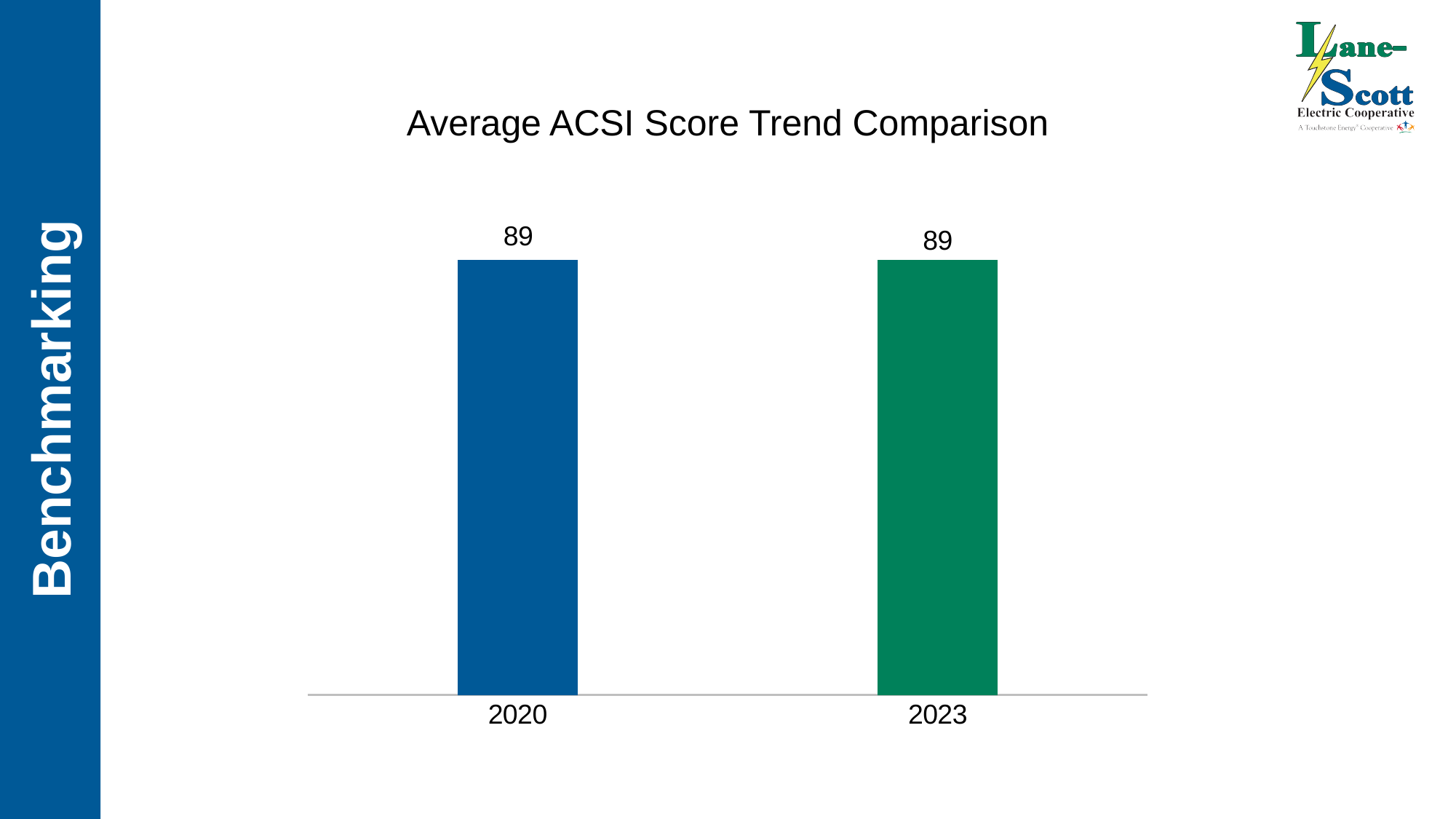
How many categories are shown on the x axis of the chart? 2 What is the title of the chart? Average ACSI Score Trend Comparison Which years are compared in the chart? 2020 and 2023 What colour is the bar for 2023? Green What is the average ACSI score for 2020? 89 What is the average ACSI score for 2023? 89 Does the average ACSI score rise, fall, or stay the same from 2020 to 2023? Stays the same What is the difference between the 2020 and 2023 average ACSI scores? 0 What kind of chart is shown on the slide? Bar chart